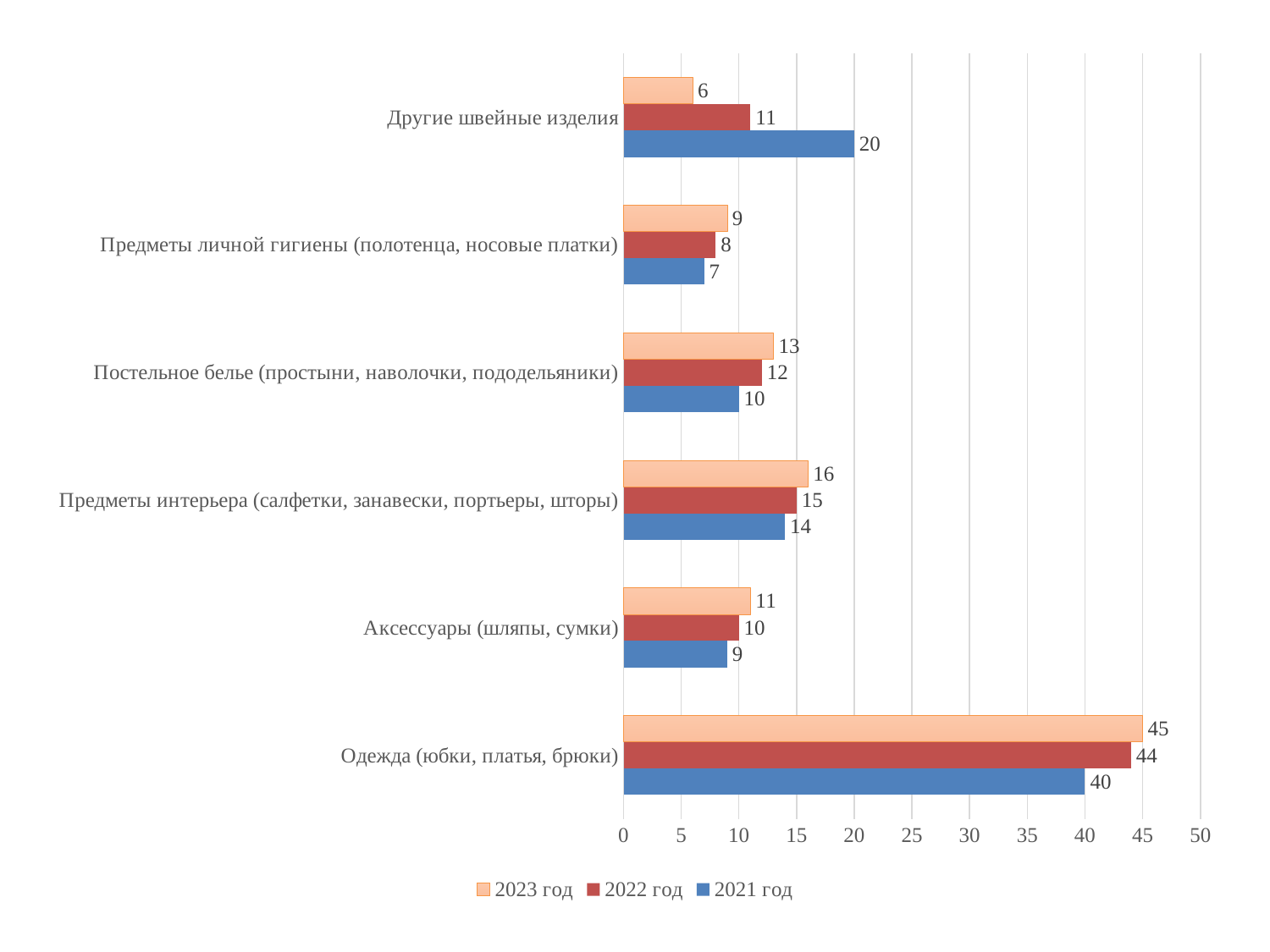
How many series does the legend list? 3 What is the value for Одежда (юбки, платья, брюки) in the 2023 год series? 45 What is the value for Предметы личной гигиены (полотенца, носовые платки) in the 2022 год series? 8 What kind of chart is shown on the slide? Bar chart Which category has the highest value in the 2022 год series? Одежда (юбки, платья, брюки) Which colour represents the 2021 год series in the legend? Blue How many categories are shown on the chart? 6 What is the value for Другие швейные изделия in the 2021 год series? 20 Which is larger for Другие швейные изделия: the 2021 год value or the 2023 год value? 2021 год What is the difference between the 2023 год and 2021 год values for Одежда (юбки, платья, брюки)? 5 What is the total of the three series values for Постельное белье (простыни, наволочки, пододельяники)? 35 Which category has the lowest value in the 2023 год series? Другие швейные изделия